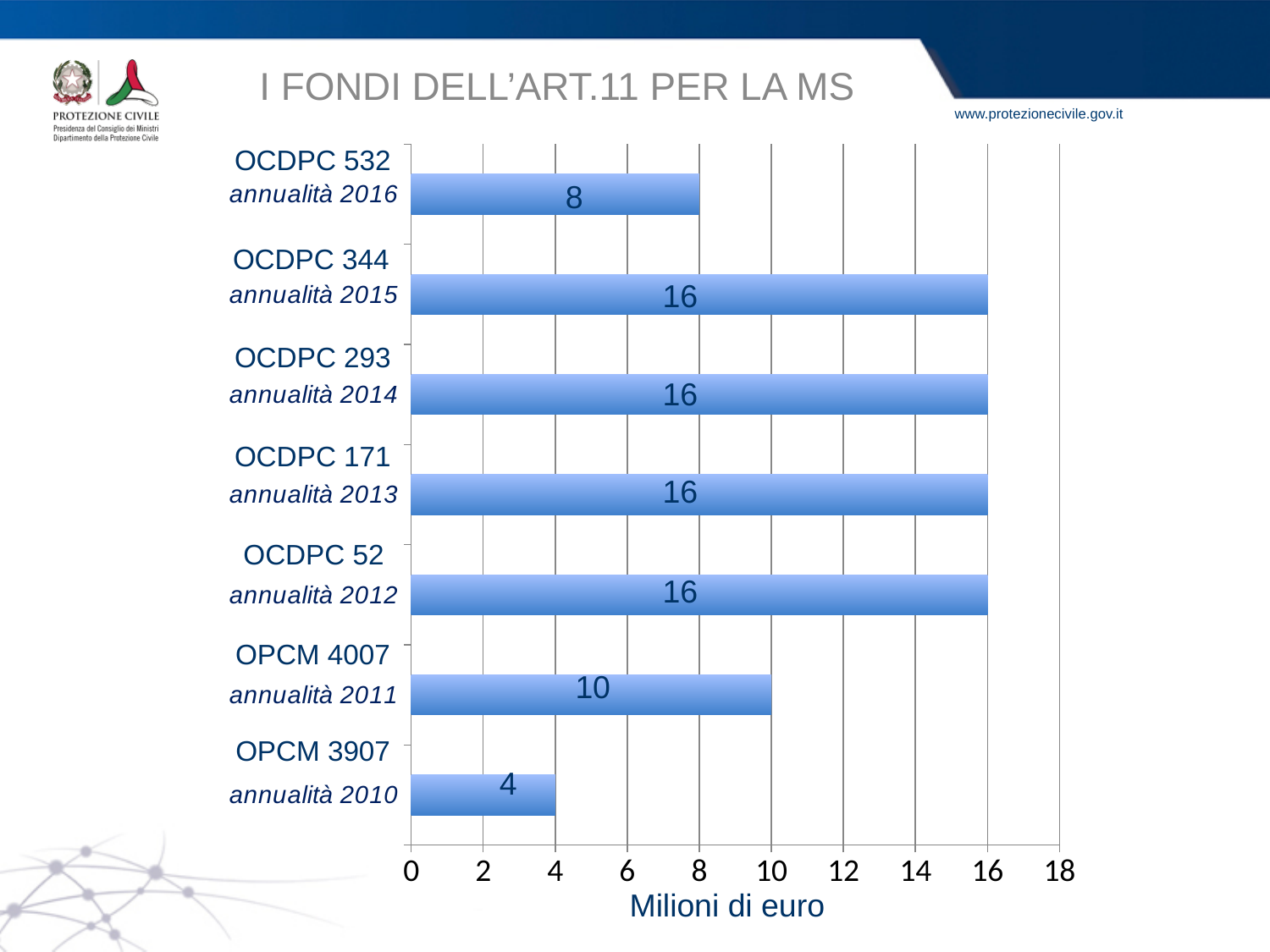
Which category has the lowest value? OPCM 3907 (annualità 2010) How many categories are shown in the chart? 7 What is the difference between the values for OCDPC 344 (annualità 2015) and OCDPC 532 (annualità 2016)? 8 What is the title of the chart? I FONDI DELL'ART.11 PER LA MS What is the label of the horizontal axis? Milioni di euro What is the value for OCDPC 532 (annualità 2016)? 8 What is the value for OPCM 4007 (annualità 2011)? 10 What is the value for OPCM 3907 (annualità 2010)? 4 What kind of chart is shown on the slide? Bar chart Which is larger, the value for OCDPC 532 (annualità 2016) or the value for OPCM 4007 (annualità 2011)? OPCM 4007 (annualità 2011) What is the difference between the values for OPCM 4007 (annualità 2011) and OPCM 3907 (annualità 2010)? 6 What is the value for OCDPC 52 (annualità 2012)? 16